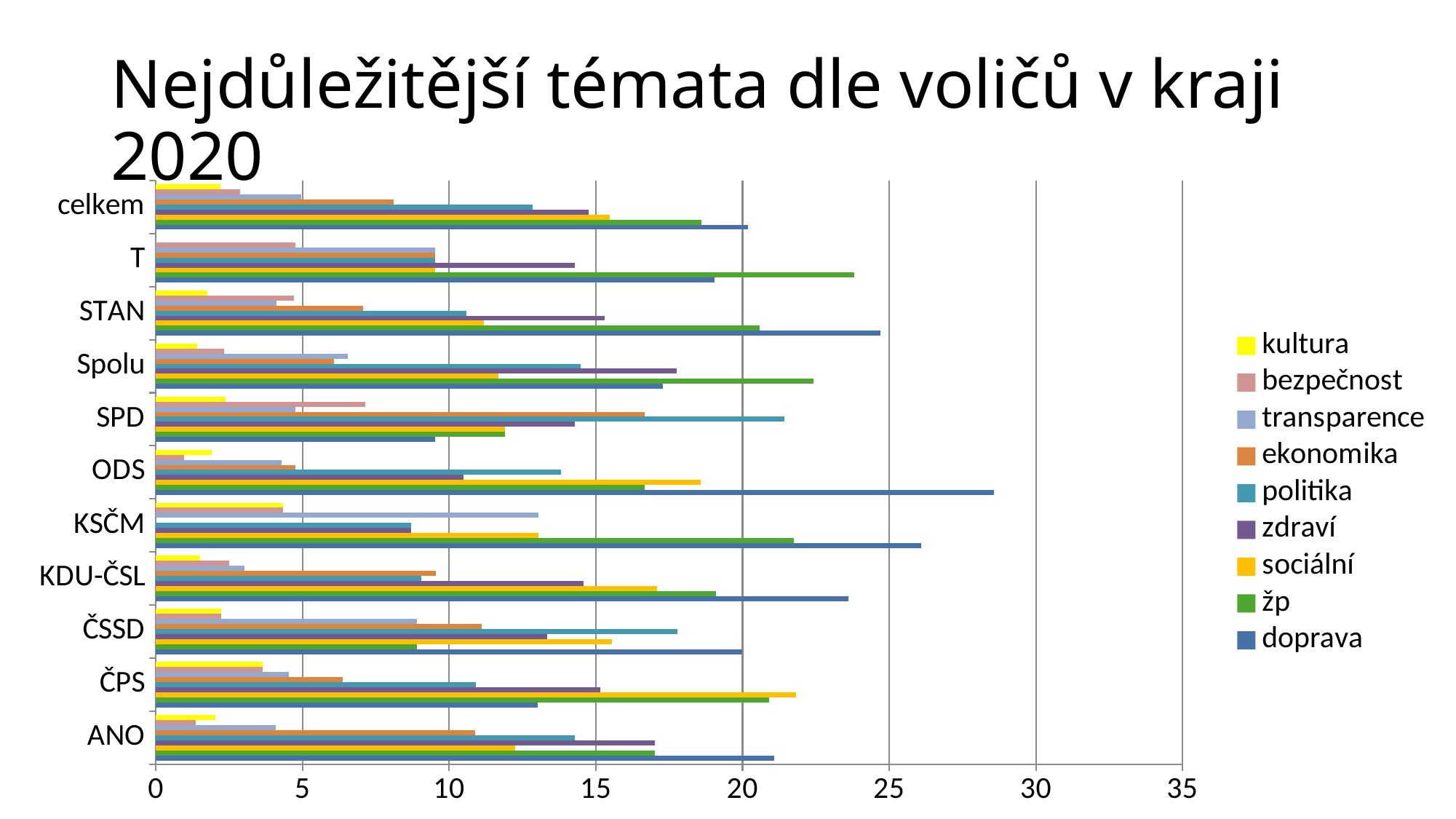
What is the title of the chart? Nejdůležitější témata dle voličů v kraji 2020 How many categories (parties plus 'celkem') are listed on the vertical axis? 11 Is the value of politika for SPD greater or less than 20? greater Is the value of kultura for ANO greater or less than 5? less Which series has the highest value for T? žp Which is larger: doprava for ODS or doprava for KSČM? ODS Which category has the highest value for doprava? ODS What kind of chart is shown on the slide? bar chart How many series does the legend list? 9 Which series is listed first in the legend? kultura Is the value of žp for T greater or less than 20? greater